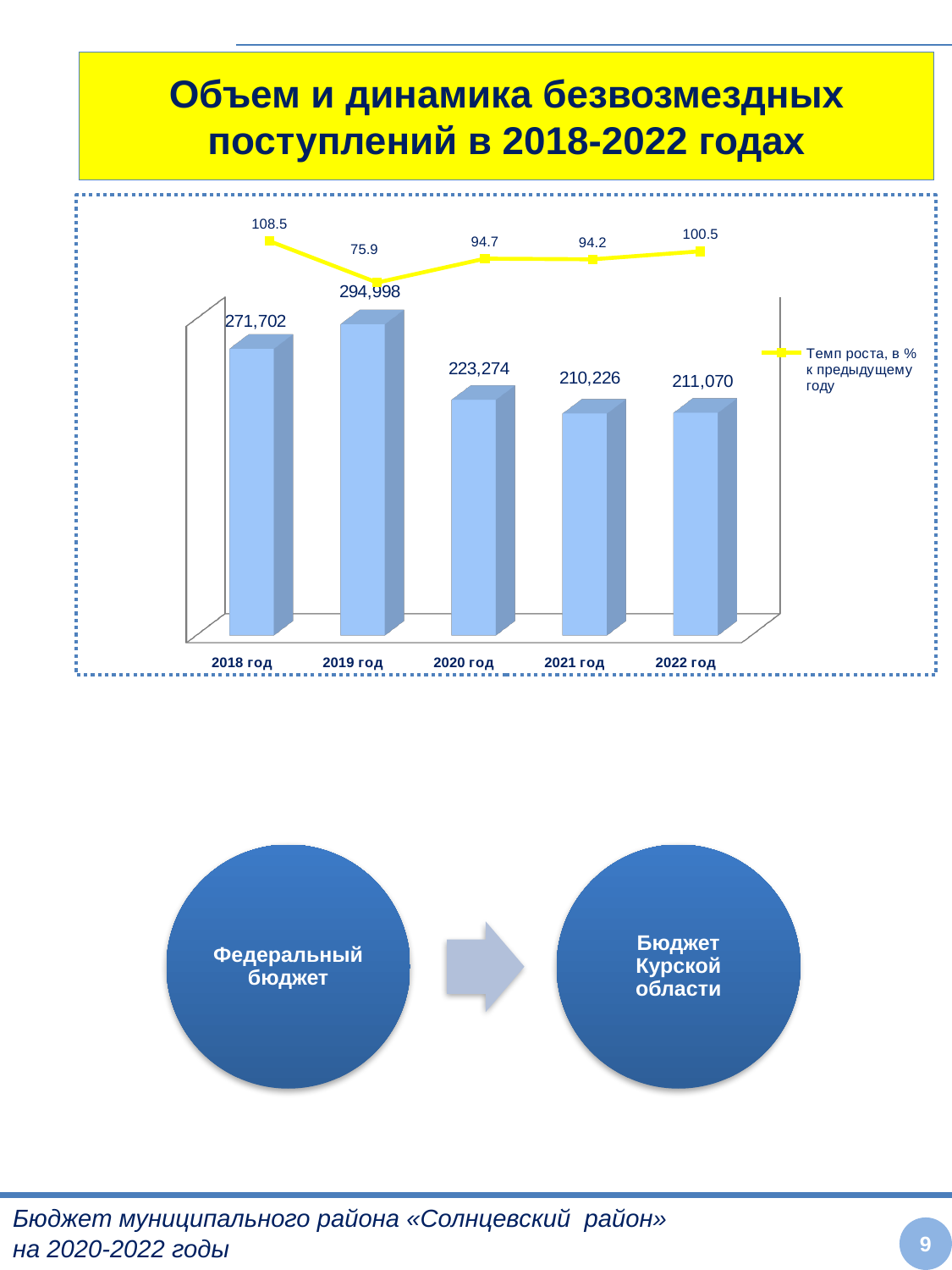
What kind of chart is shown on the slide? Bar chart with a line How many years are shown on the x axis of the chart? 5 Which is larger, the bar value for 2020 год or for 2022 год? 2020 год What is the difference between the bar values for 2019 год and 2018 год? 23,296 Which year has the lowest bar value? 2021 год What is the growth rate (Темп роста) value shown for 2022 год? 100.5 Which year has the lowest growth rate (Темп роста) value on the line? 2019 год What is the growth rate (Темп роста) value shown for 2019 год? 75.9 What is the value of the bar for 2019 год? 294,998 What is the legend entry shown on the chart? Темп роста, в % к предыдущему году Which year has the highest bar value? 2019 год What is the value of the bar for 2021 год? 210,226